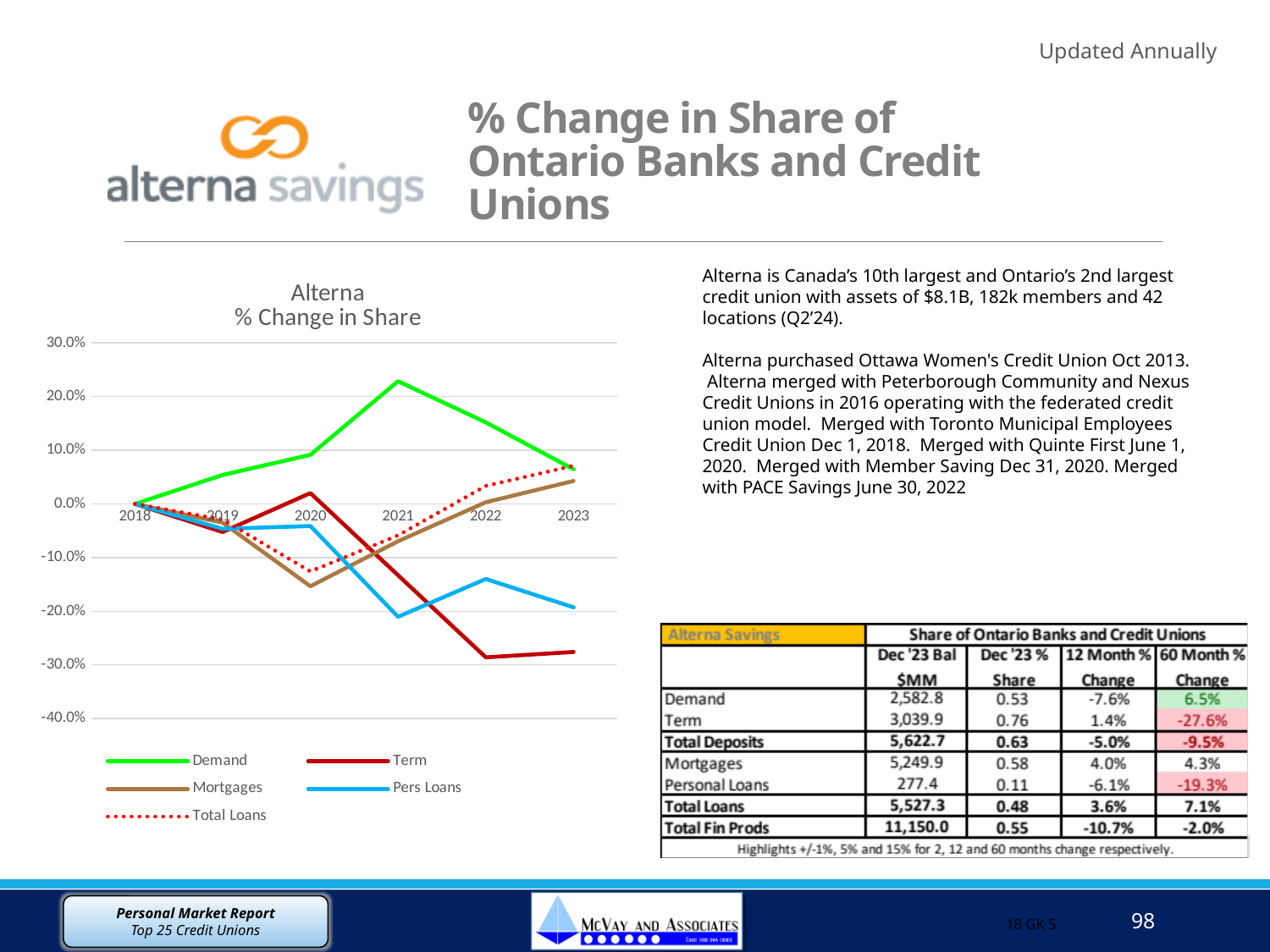
How many series does the legend of the "Alterna % Change in Share" chart list? 5 How many years are plotted along the x axis of the "Alterna % Change in Share" chart? 6 In the "Alterna % Change in Share" chart, which series has the lowest value in 2022? Term What kind of chart is the "Alterna % Change in Share" chart? line chart In the "Alterna % Change in Share" chart, which is larger in 2021: Demand or Term? Demand In the "Alterna % Change in Share" chart, which series is drawn as a dotted line? Total Loans In the "Alterna % Change in Share" chart, which series has the highest value in 2021? Demand In the "Alterna % Change in Share" chart, is the Mortgages value for 2020 greater or less than -10.0%? less In the "Alterna % Change in Share" chart, is the Term value for 2022 greater or less than -20.0%? less In the "Alterna % Change in Share" chart, does the Term series rise or fall from 2020 to 2022? fall In the "Alterna % Change in Share" chart, is the Demand value for 2021 greater or less than 20.0%? greater In the "Alterna % Change in Share" chart, does the Demand series rise or fall from 2018 to 2021? rise